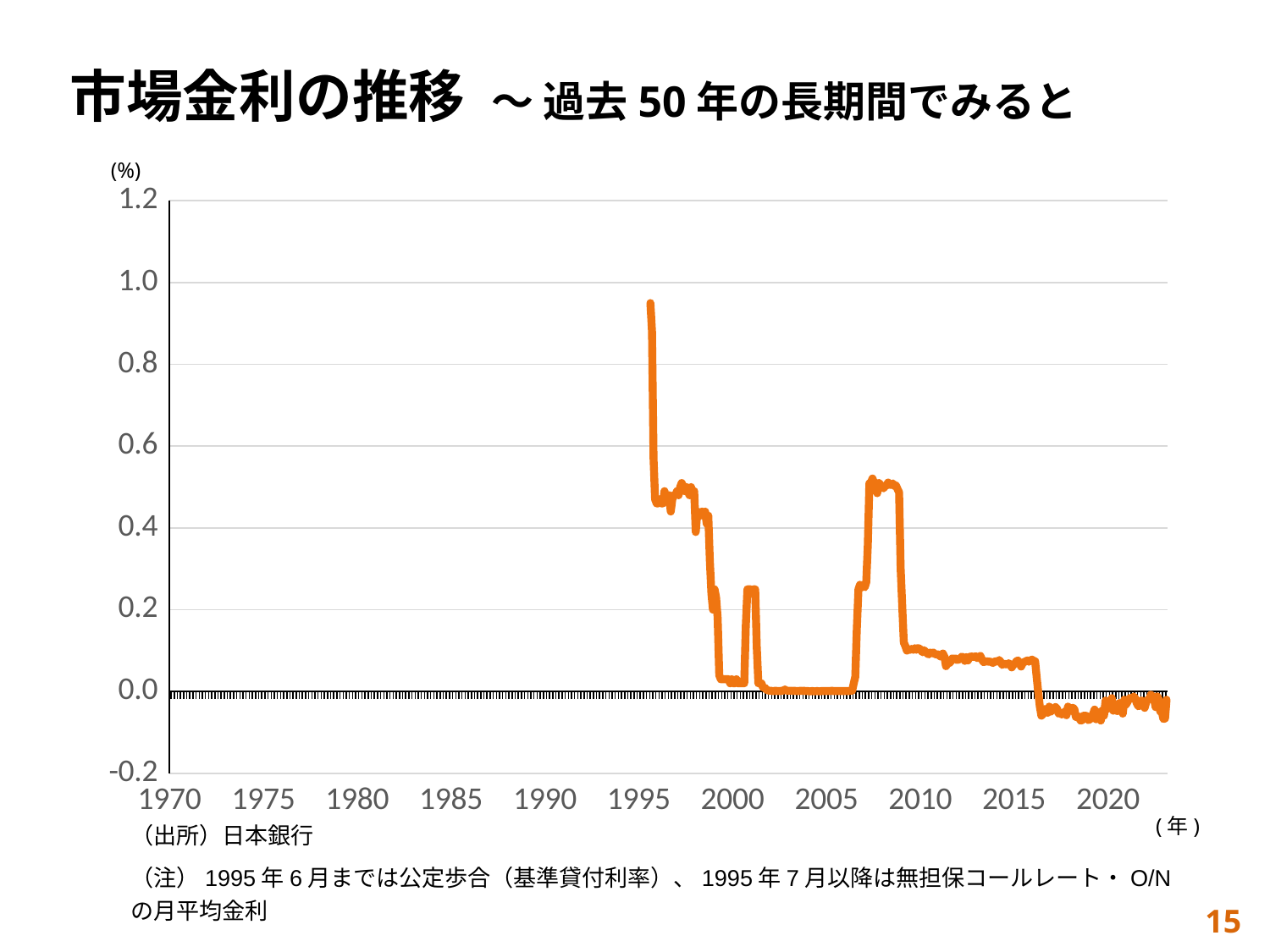
Which is larger, the value around 2008 or the value around 2012? 2008 What unit is shown at the top of the vertical axis? (%) Is the value around 1997 greater or less than 0.2? greater Is the value around 2019 greater or less than 0.0? less Does the line rise or fall between 2008 and 2010? fall Is the value around 2003 greater or less than 0.2? less What kind of chart is shown on the slide? line chart Does the line rise or fall between 2006 and 2007? rise Around which year does the line reach its highest point? 1995 According to the note below the chart, what is the source of the data? 日本銀行